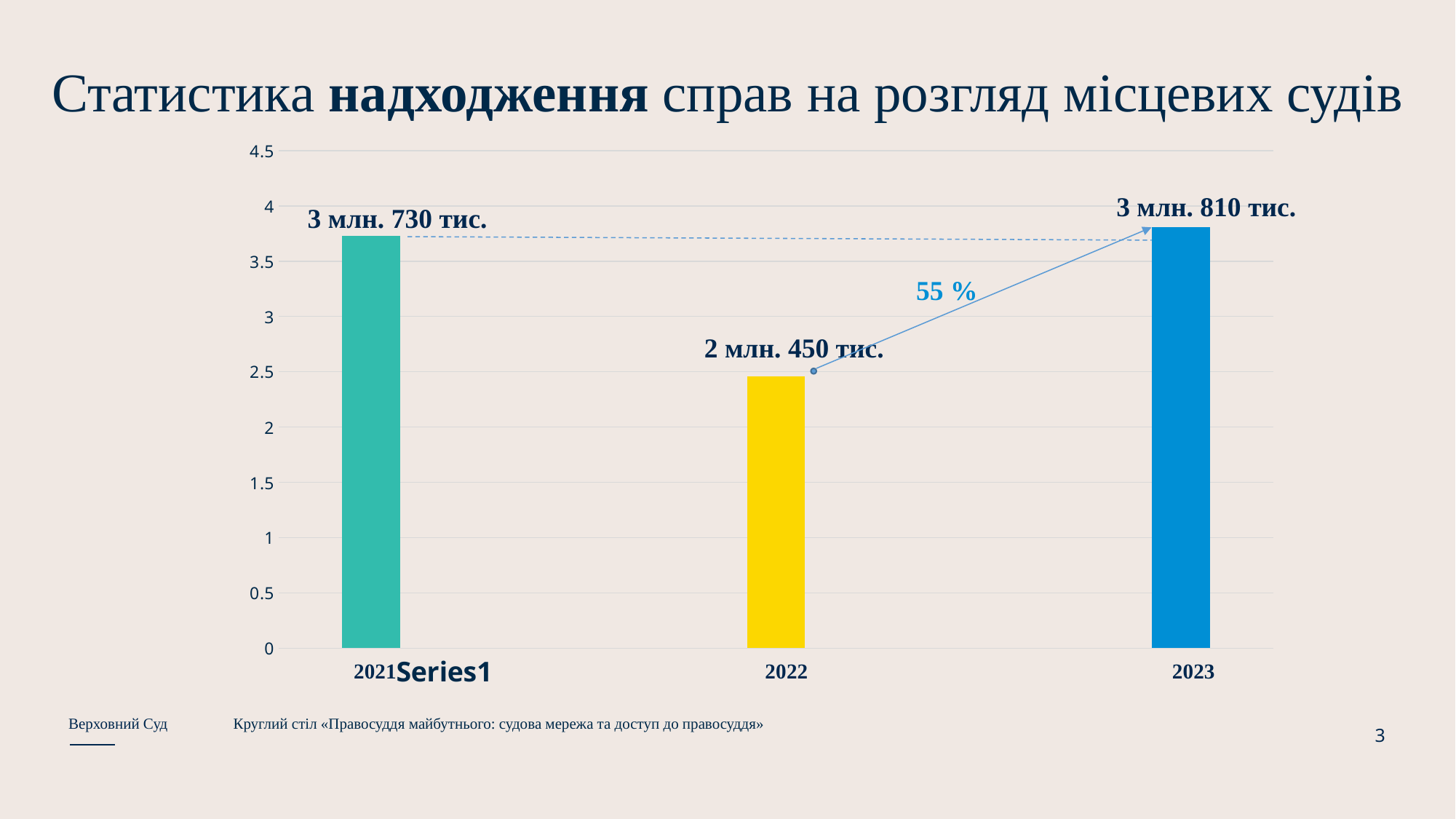
What percentage is written next to the arrow between the 2022 and 2023 bars? 55 % What kind of chart is shown on the slide? bar chart What is the difference between the values for 2023 and 2022? 1 млн. 360 тис. What value is shown for 2021? 3 млн. 730 тис. Which year has the highest value? 2023 What value is shown for 2022? 2 млн. 450 тис. Is the value for 2022 greater or less than 3? less What value is shown for 2023? 3 млн. 810 тис. Which year has the lowest value? 2022 Which is larger, the value for 2021 or the value for 2022? 2021 How many bars are shown in the chart? 3 What is the difference between the values for 2023 and 2021? 80 тис.